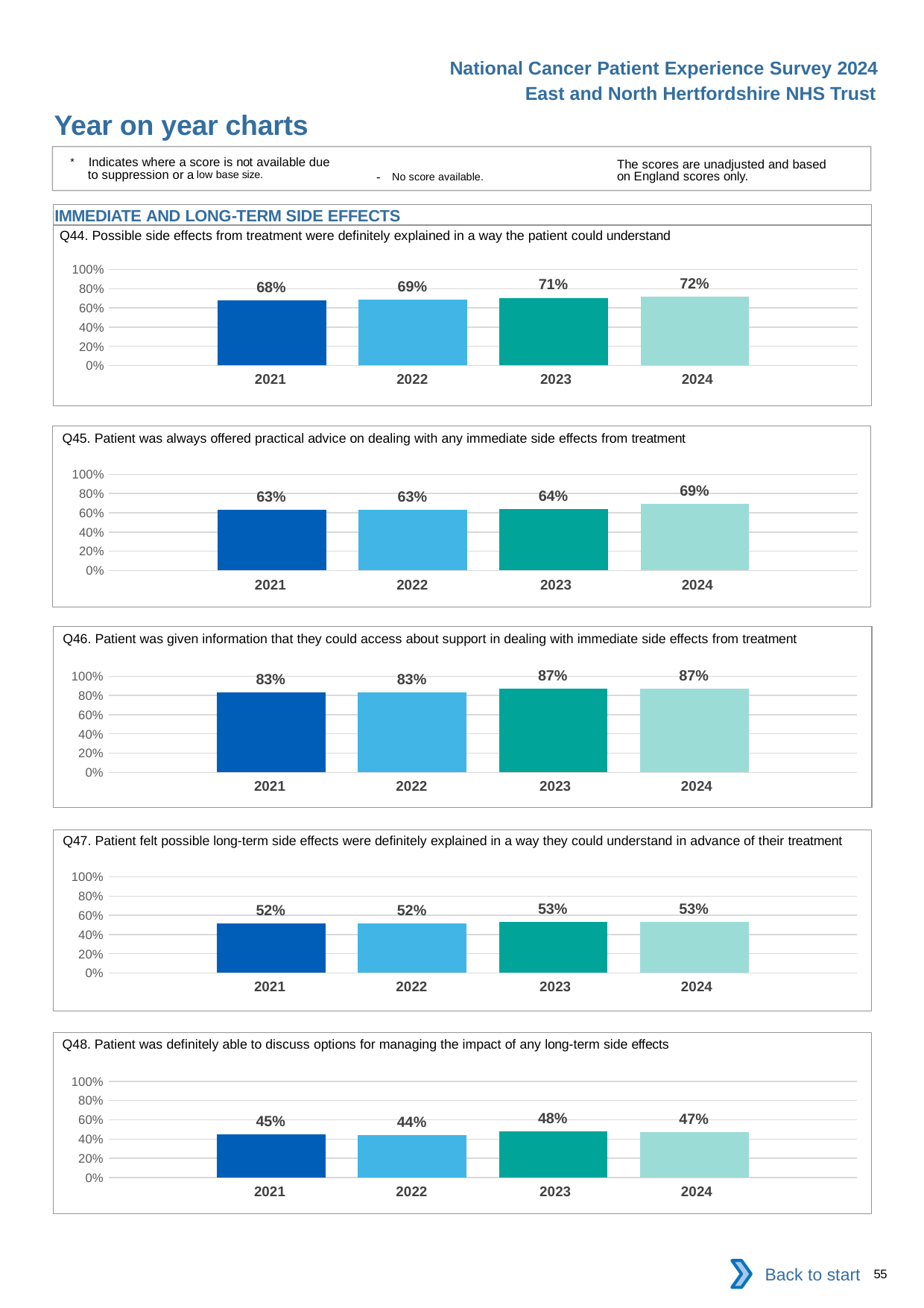
How many years are shown in the Q44 chart? 4 In the Q48 chart, which is larger, the value for 2023 or the value for 2024? 2023 In the Q45 chart, what is the difference between the 2024 and 2023 values? 5% What kind of chart is the Q48 chart? bar chart In the Q47 chart, is the value for 2021 greater or less than 60%? less In the Q48 chart, which year has the lowest value? 2022 In the Q45 chart, which year has the highest value? 2024 In the Q44 chart, what is the value for 2024? 72% In the Q44 chart, do the values rise or fall from 2021 to 2024? rise In the Q46 chart, what is the value for 2021? 83% In the Q46 chart, is the value for 2023 greater or less than 80%? greater In the Q47 chart, what is the value for 2023? 53%